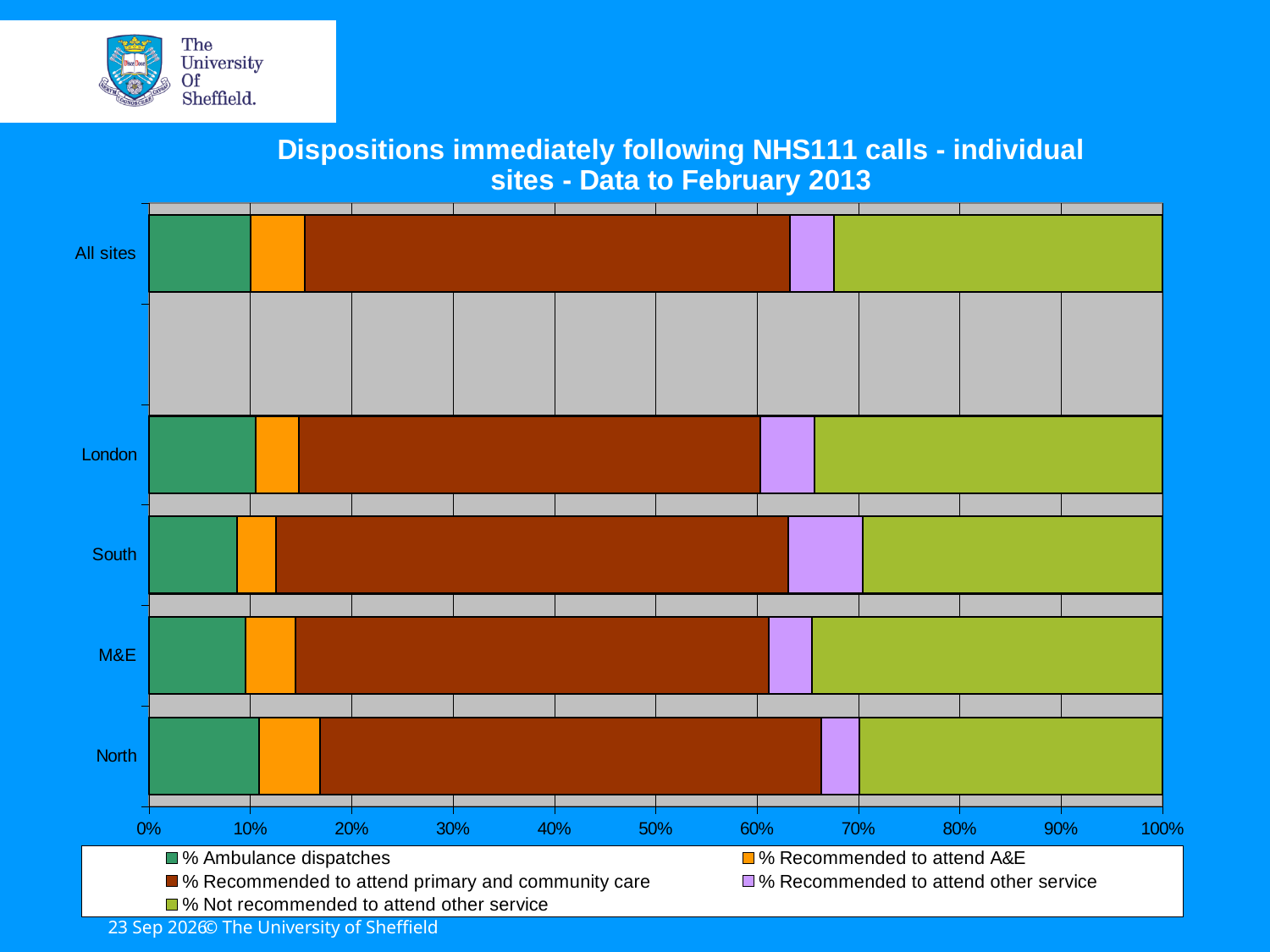
Which has the larger % Not recommended to attend other service value, M&E or South? M&E How many labelled sites (categories) are shown on the vertical axis? 5 What kind of chart is shown on the slide? Stacked bar chart Is the % Not recommended to attend other service value for M&E greater or less than 30%? greater Which series is shown in orange in the legend? % Recommended to attend A&E What is the title of the chart? Dispositions immediately following NHS111 calls - individual sites - Data to February 2013 Which site has the smallest % Ambulance dispatches segment? South Is the % Ambulance dispatches value for South greater or less than 10%? less What is the maximum value shown on the horizontal axis? 100% How many series does the legend list? 5 Is the % Recommended to attend primary and community care value for London greater or less than 50%? less Which has the larger % Ambulance dispatches value, South or North? North